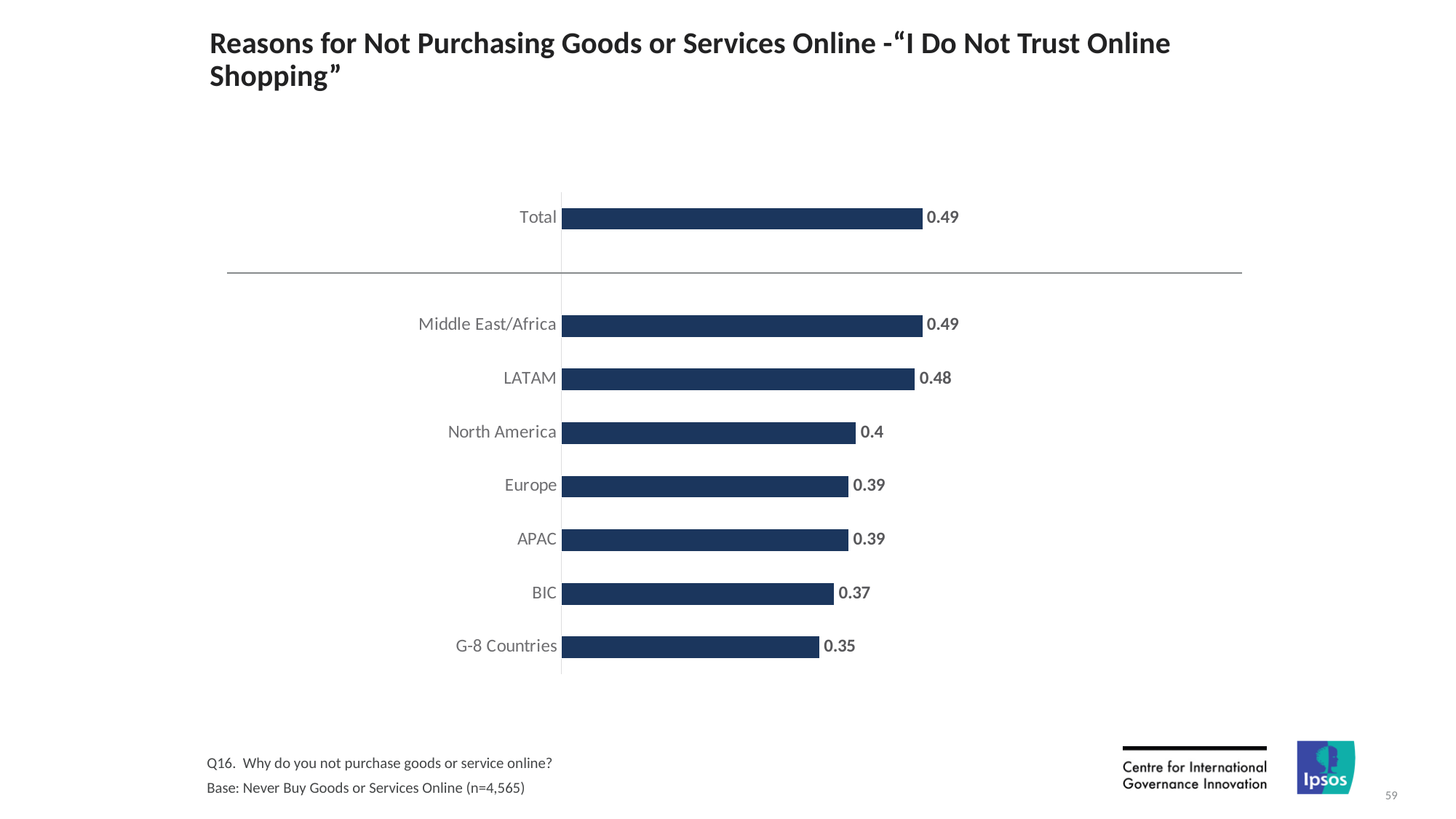
What is the value for G-8 Countries? 0.35 Among the regions below the Total bar, which has the highest value? Middle East/Africa What kind of chart is shown on the slide? Bar chart What is the value for Total? 0.49 What is the difference between the values for North America and BIC? 0.03 Which region has the lowest value? G-8 Countries What is the value for LATAM? 0.48 What is the value for North America? 0.4 What is the difference between the values for Middle East/Africa and G-8 Countries? 0.14 What is the base sample size (n) stated at the bottom of the slide? 4,565 Which is larger, the value for LATAM or the value for Europe? LATAM How many bars are plotted on the chart, including Total? 8